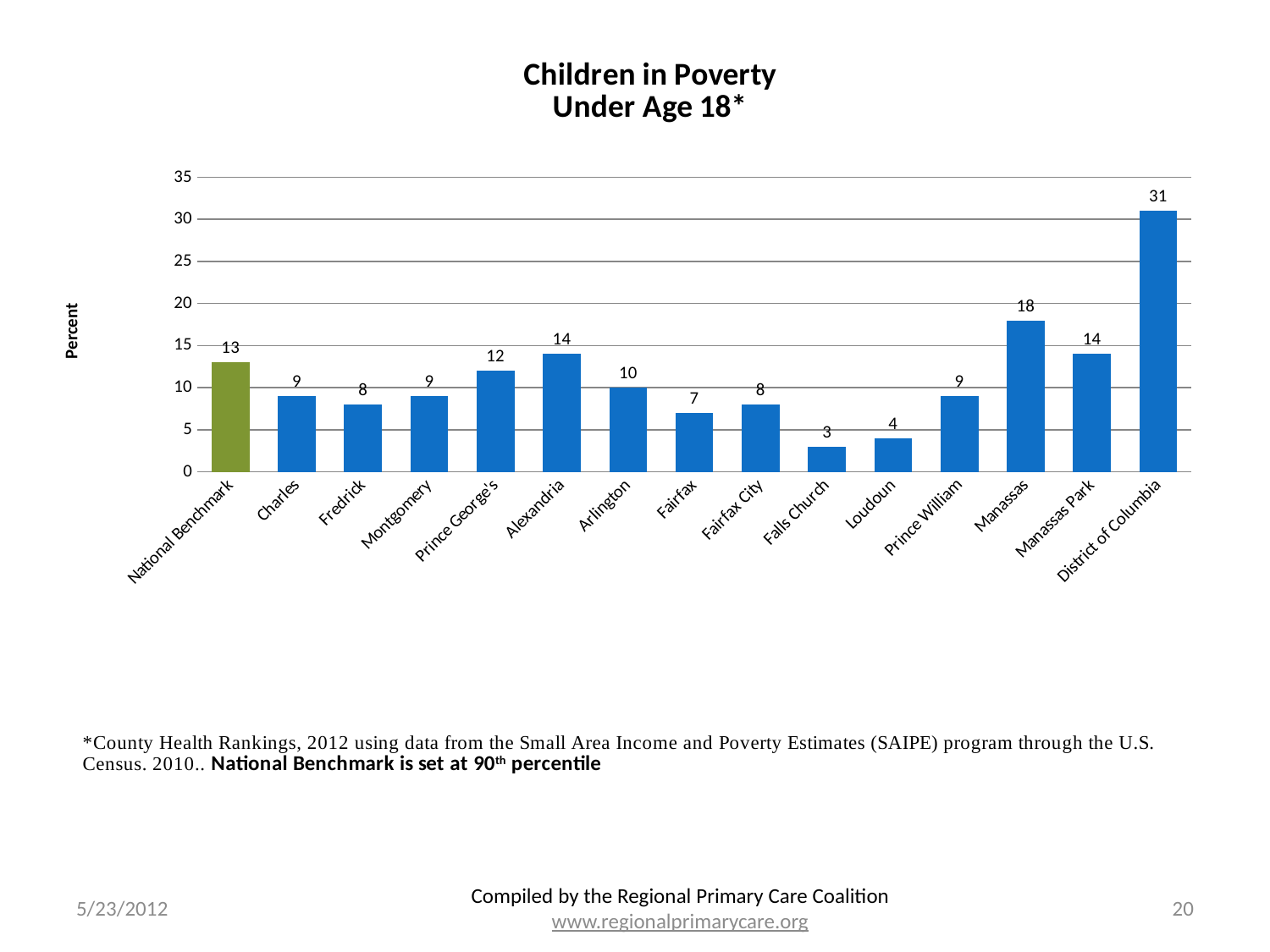
What is the value for Loudoun? 4 What is the value for District of Columbia? 31 What is the label on the y axis? Percent Which category has the highest value? District of Columbia What is the value for the National Benchmark? 13 Which category has the lowest value? Falls Church What is the difference between the values for District of Columbia and Manassas? 13 What is the value for Manassas? 18 How many categories are shown on the x axis? 15 What is the title of the chart? Children in Poverty Under Age 18* What kind of chart is shown on the slide? Bar chart Which is larger, the value for Alexandria or the value for Arlington? Alexandria